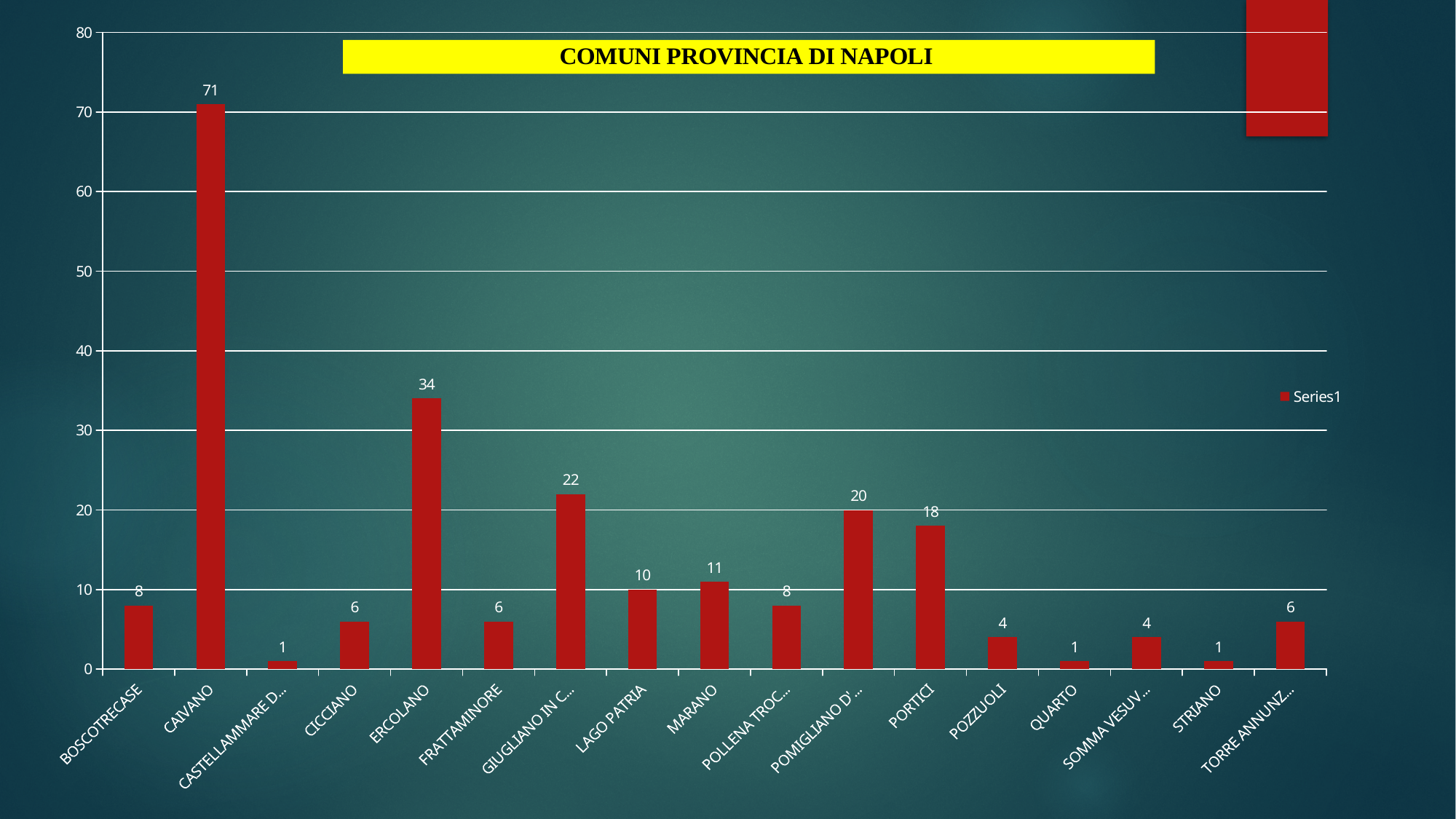
What kind of chart is shown on the slide? bar chart What is the value for MARANO? 11 What is the difference between the values for CAIVANO and ERCOLANO? 37 How many categories are shown on the x axis? 17 What is the value for PORTICI? 18 What is the value for CAIVANO? 71 What is the value for ERCOLANO? 34 Which category has the highest value? CAIVANO Is the value for ERCOLANO greater or less than 30? greater Which is larger, the value for PORTICI or the value for MARANO? PORTICI How many series does the legend list? 1 What is the difference between the values for LAGO PATRIA and POZZUOLI? 6